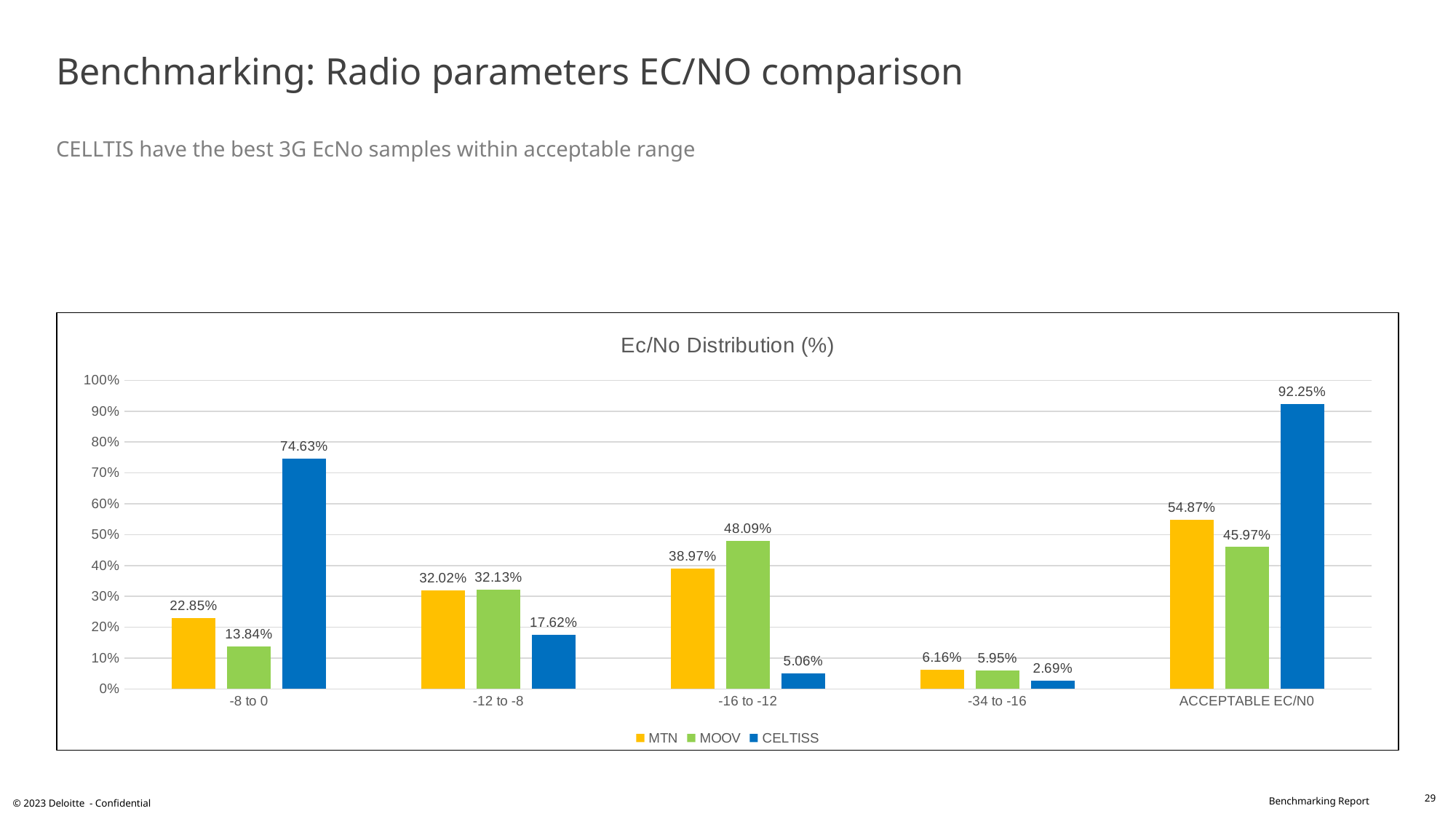
What is the value for MTN in the ACCEPTABLE EC/N0 category? 54.87% How many categories are shown on the x axis? 5 What kind of chart is shown on the slide? Bar chart How many series does the legend list? 3 In the -16 to -12 category, which is larger: the MTN value or the MOOV value? MOOV What is the value for MOOV in the -16 to -12 category? 48.09% What is the difference between the MTN and MOOV values in the -8 to 0 category? 9.01% Which series has the lowest value in the -34 to -16 category? CELTISS What is the value for CELTISS in the -8 to 0 category? 74.63% Is the value for CELTISS in the ACCEPTABLE EC/N0 category greater or less than 90%? greater Which series has the highest value in the ACCEPTABLE EC/N0 category? CELTISS What is the title of the chart? Ec/No Distribution (%)